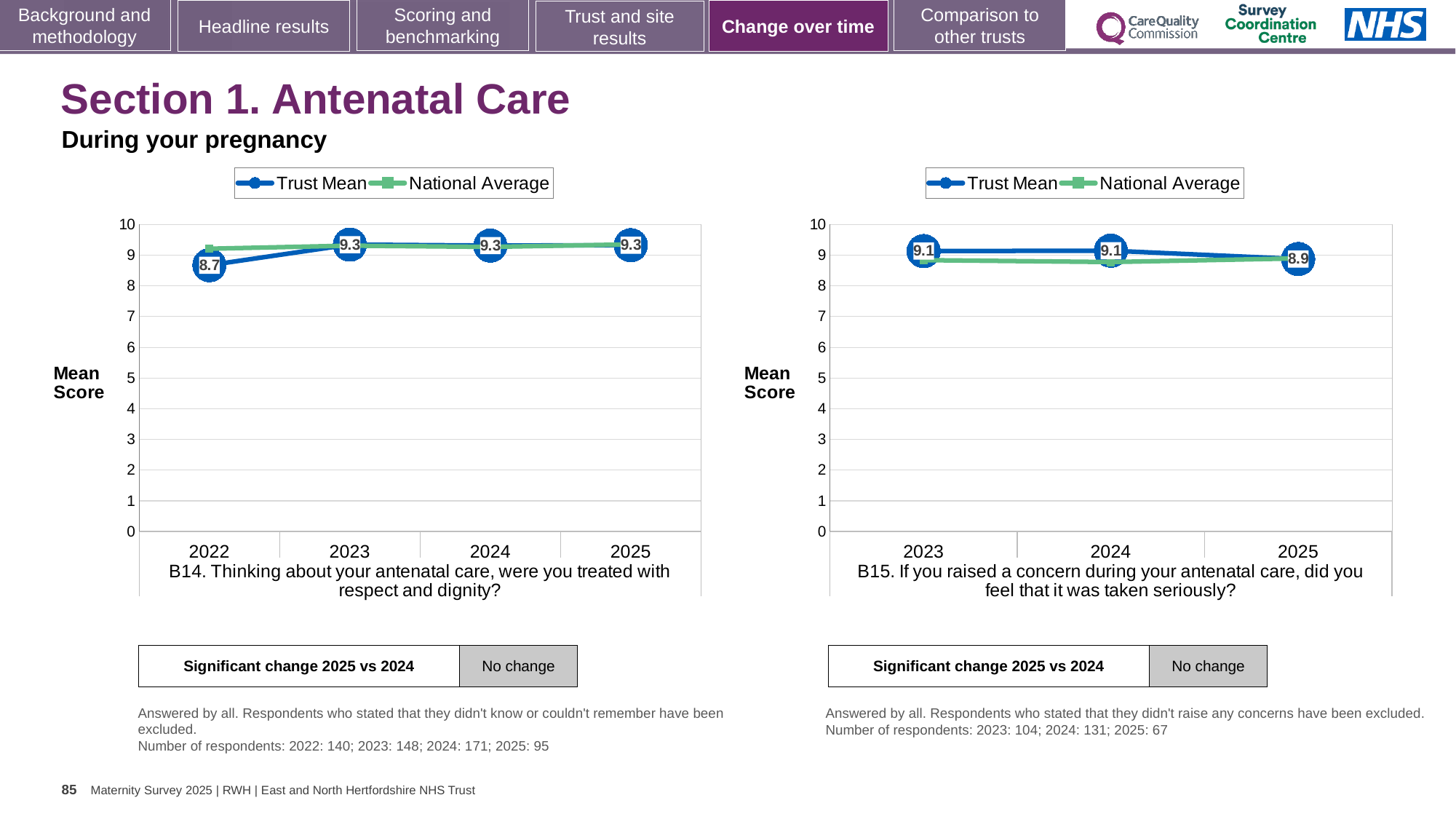
In the B14 chart, does the Trust Mean rise or fall from 2022 to 2023? rise In the B15 chart, what is the Trust Mean score for 2025? 8.9 In the B14 chart, what is the Trust Mean score for 2022? 8.7 In the B15 chart, which year has the lowest Trust Mean score? 2025 In the B15 chart, is the Trust Mean score for 2025 greater or less than 8? greater In the B14 chart, what is the difference between the Trust Mean scores for 2023 and 2022? 0.6 In the B15 chart, how many series does the legend list? 2 In the B14 chart, what is the Trust Mean score for 2025? 9.3 In the B14 chart, which year has the lowest Trust Mean score? 2022 In the B14 chart, how many years are shown on the x axis? 4 What kind of chart is the B15 chart? line chart In the B15 chart, what is the Trust Mean score for 2023? 9.1